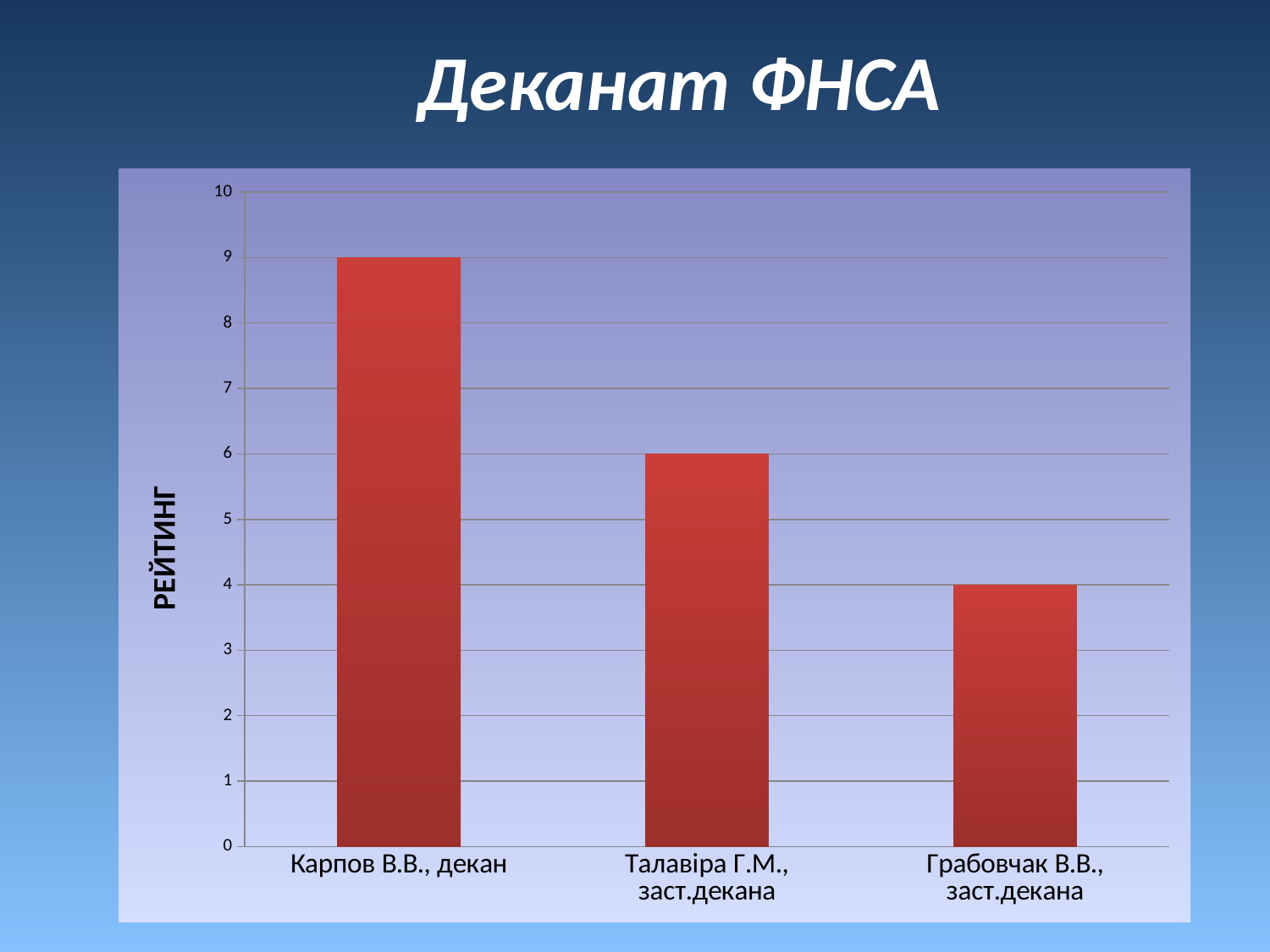
What kind of chart is shown on the slide? bar chart Which has a higher rating, Талавіра Г.М., заст.декана or Грабовчак В.В., заст.декана? Талавіра Г.М., заст.декана What is the rating value for Грабовчак В.В., заст.декана? 4 What is the label of the vertical axis? РЕЙТИНГ Which category has the highest rating? Карпов В.В., декан What is the difference between the ratings of Талавіра Г.М., заст.декана and Грабовчак В.В., заст.декана? 2 What is the rating value for Талавіра Г.М., заст.декана? 6 Is the value for Карпов В.В., декан greater or less than 8? greater What is the difference between the ratings of Карпов В.В., декан and Грабовчак В.В., заст.декана? 5 Which category has the lowest rating? Грабовчак В.В., заст.декана What is the rating value for Карпов В.В., декан? 9 How many categories are shown on the chart? 3